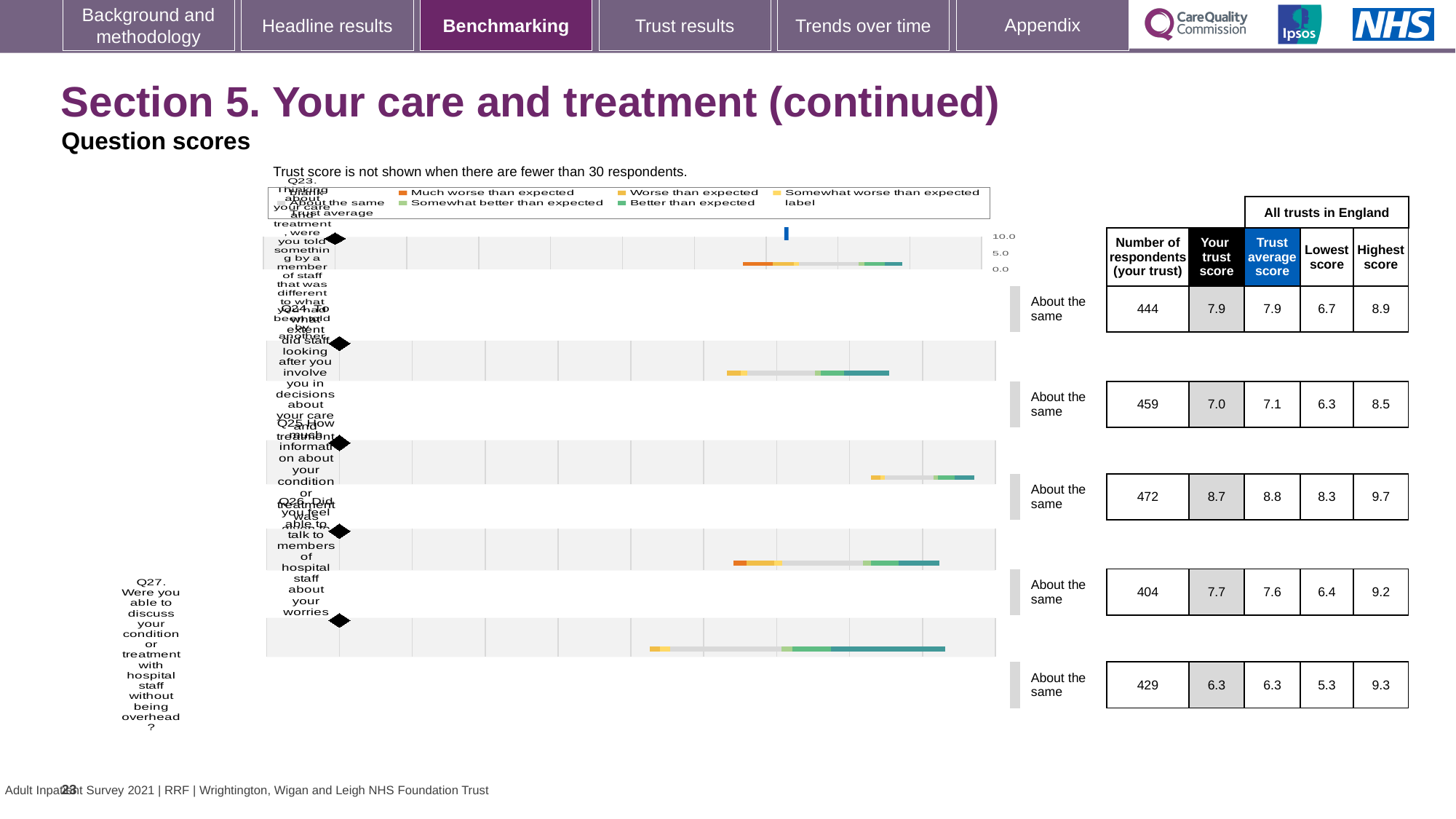
What is the number of respondents for Q23? 444 What is the trust average score for Q25? 8.8 What benchmark category is shown for Q26? About the same Which question has the lowest 'Your trust score'? Q27 What is the highest score across all trusts in England for Q27? 9.3 What is the difference between the highest score (9.7) and the lowest score (8.3) for Q25? 1.4 Which is larger, the trust score for Q23 or the trust score for Q24? Q23 How many questions (Q23 to Q27) are plotted on the chart? 5 What is the trust score for Q24 (to what extent did staff involve you in decisions about your care and treatment)? 7.0 Which question has the highest 'Your trust score'? Q25 What kind of chart is used to show the question scores on this slide? bar chart What is the lowest score across all trusts in England for Q26? 6.4